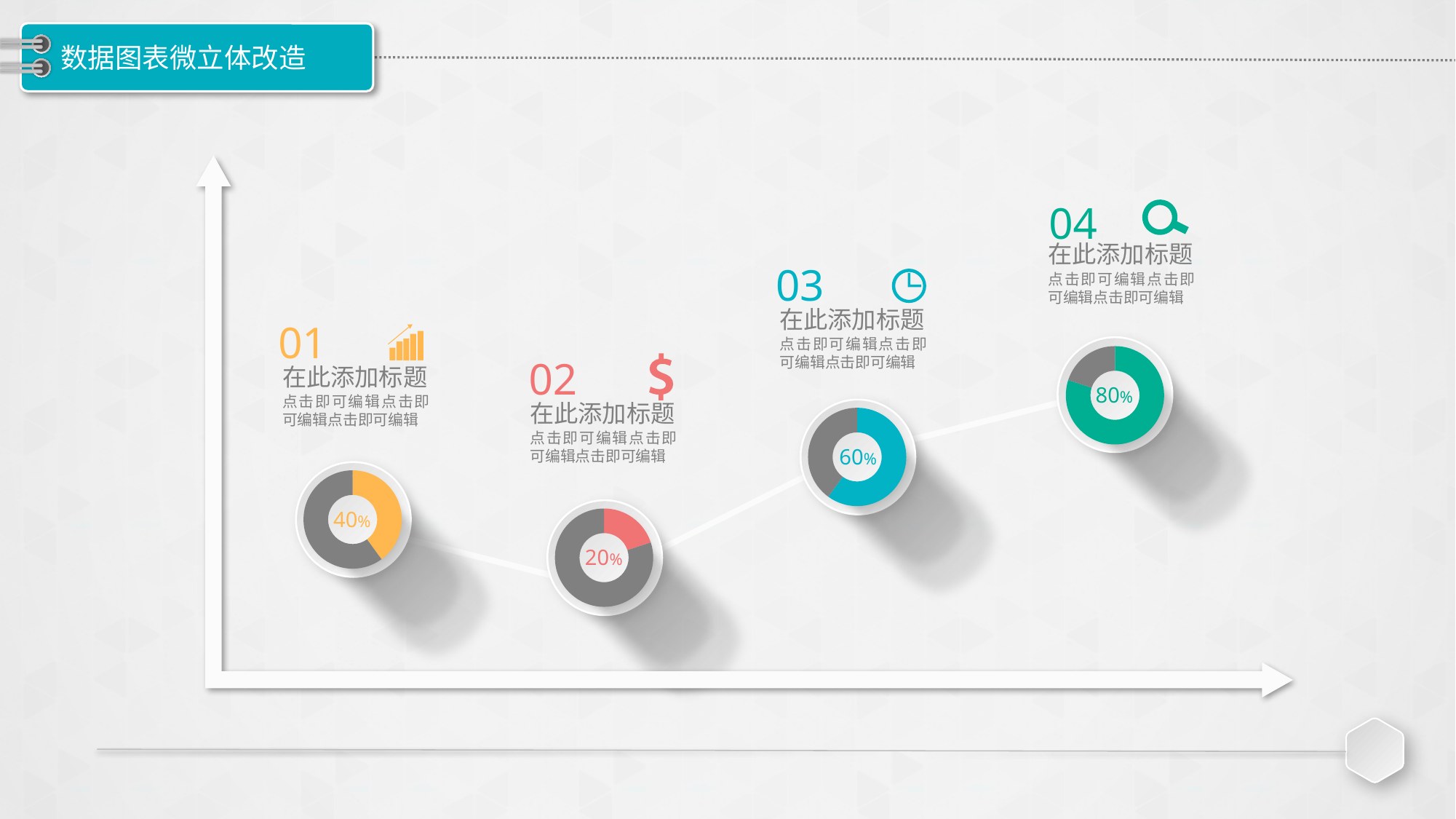
What is the difference between the percentages in the item 03 and item 01 donut charts? 20% What kind of chart is used to show each percentage on the slide? donut chart How many donut charts are on the slide? 4 Which item's donut chart shows the highest percentage? 04 What colour is the filled segment of the donut chart under item 03? blue What value is shown in the donut chart under item 01? 40% What value is shown in the donut chart under item 03? 60% What is the difference between the percentage in the item 04 donut and the item 02 donut? 60% What value is shown in the donut chart under item 04 (rightmost)? 80% Which item's donut chart shows the lowest percentage? 02 Which is larger, the percentage in the item 01 donut or the item 03 donut? item 03 What value is shown in the donut chart under item 02? 20%